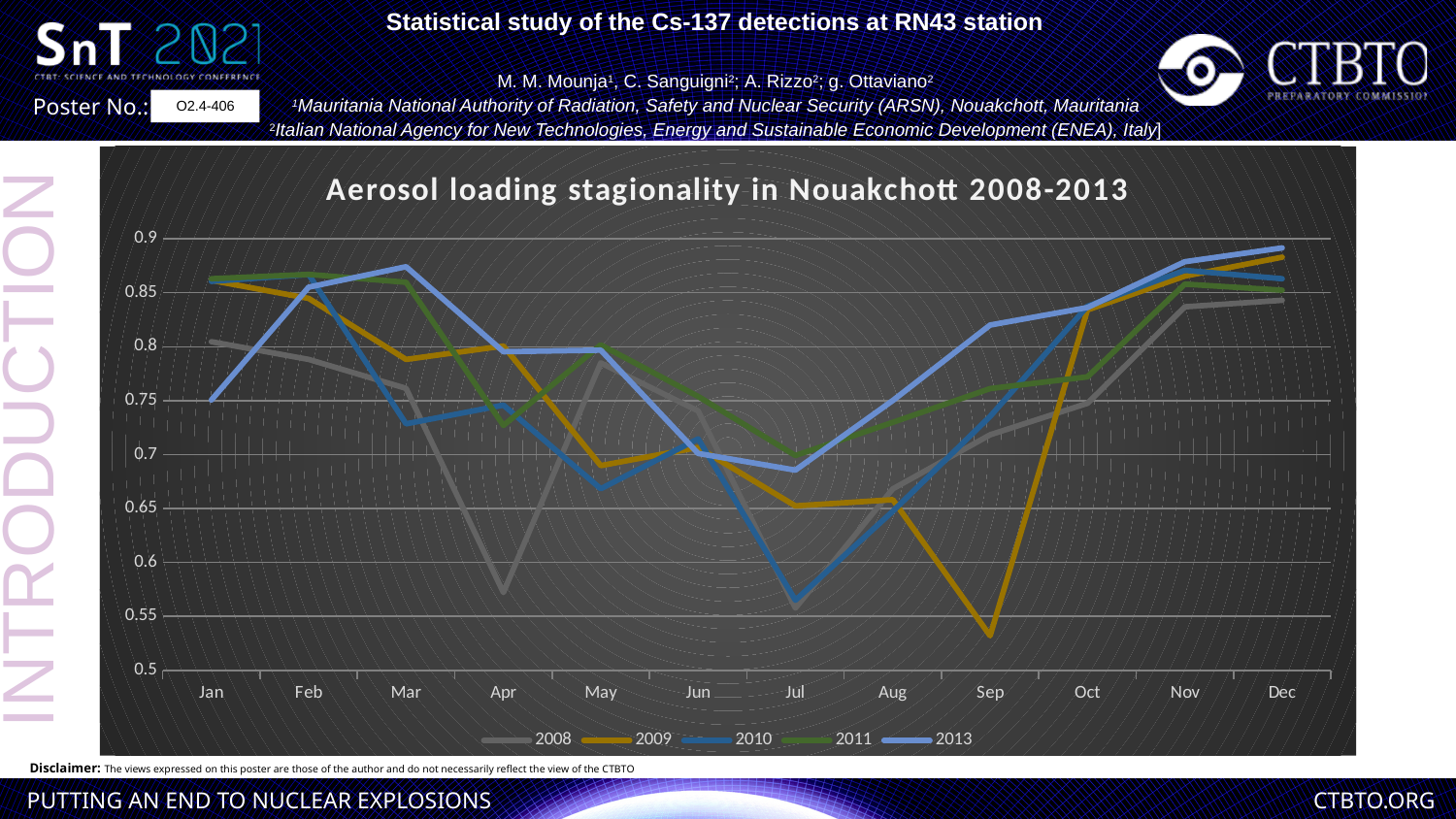
How many series does the legend list? 5 What is the title of the chart? Aerosol loading stagionality in Nouakchott 2008-2013 Is the value for 2009 in Sep greater or less than 0.6? less Do the values for 2009 rise or fall from Sep to Dec? rise Is the value for 2008 in Apr greater or less than 0.6? less What kind of chart is shown on the slide? line chart How many months are shown along the x axis? 12 Which series has the lowest value in Sep? 2009 Is the value for 2013 in Sep greater or less than 0.8? greater Which years are listed in the legend? 2008, 2009, 2010, 2011, 2013 Which series has the highest value in Sep? 2013